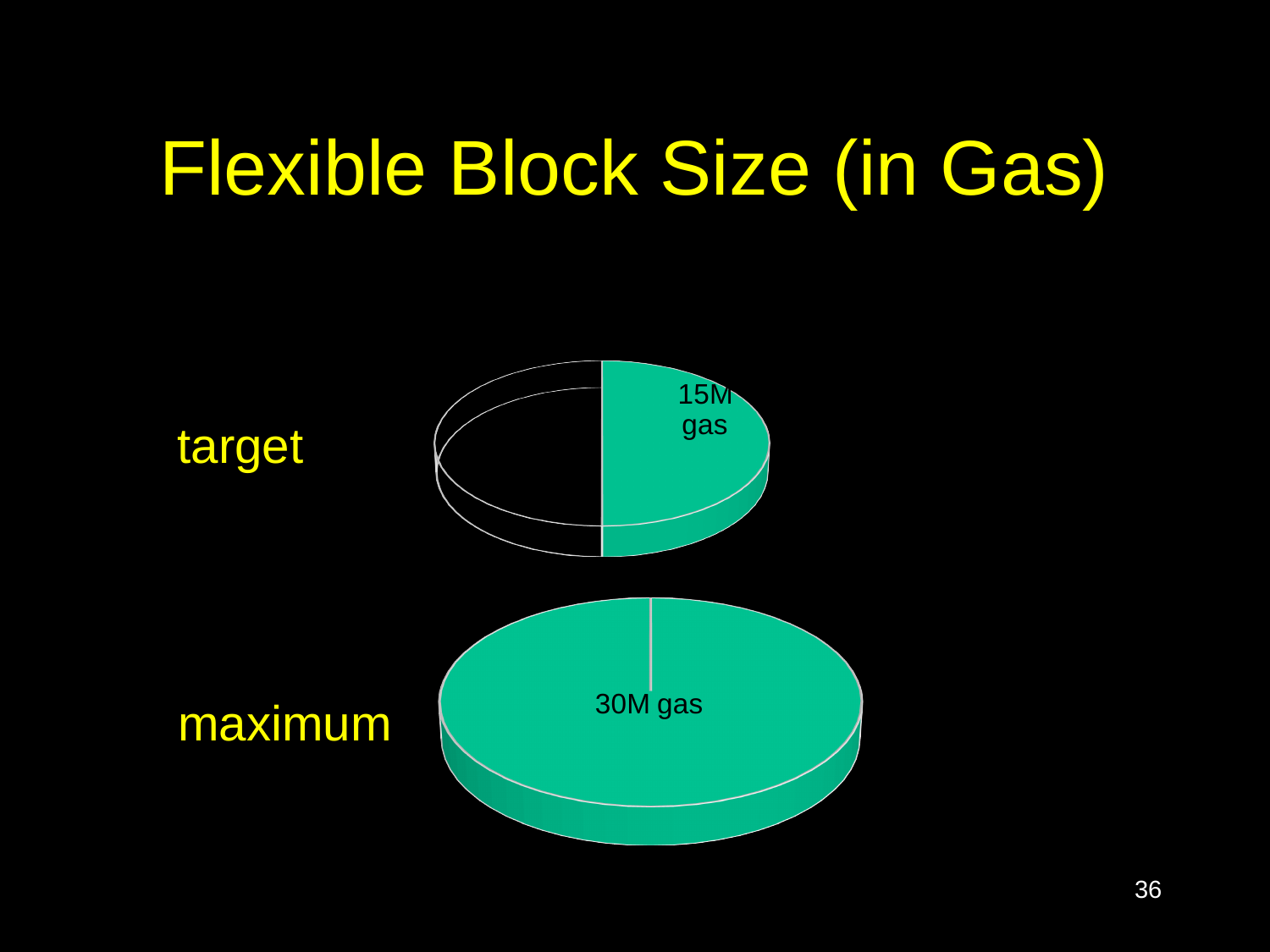
What is the gas value labelled for the maximum block size? 30M gas What is the gas value labelled for the target block size? 15M gas How many pie charts are on the slide? 2 In the bottom pie chart (maximum), what value is printed on the pie? 30M gas What colour are the filled slices in the pie charts? Green In the bottom pie chart (maximum), how much of the pie is filled in green? All of it What is the title of the slide containing the pie charts? Flexible Block Size (in Gas) What is the difference between the maximum gas value and the target gas value? 15M gas In the top pie chart (target), what share of the pie is filled in green? Half Which is larger, the target gas value or the maximum gas value? maximum What kind of charts are shown on the slide? Pie charts In the top pie chart (target), what value is printed on the filled slice? 15M gas